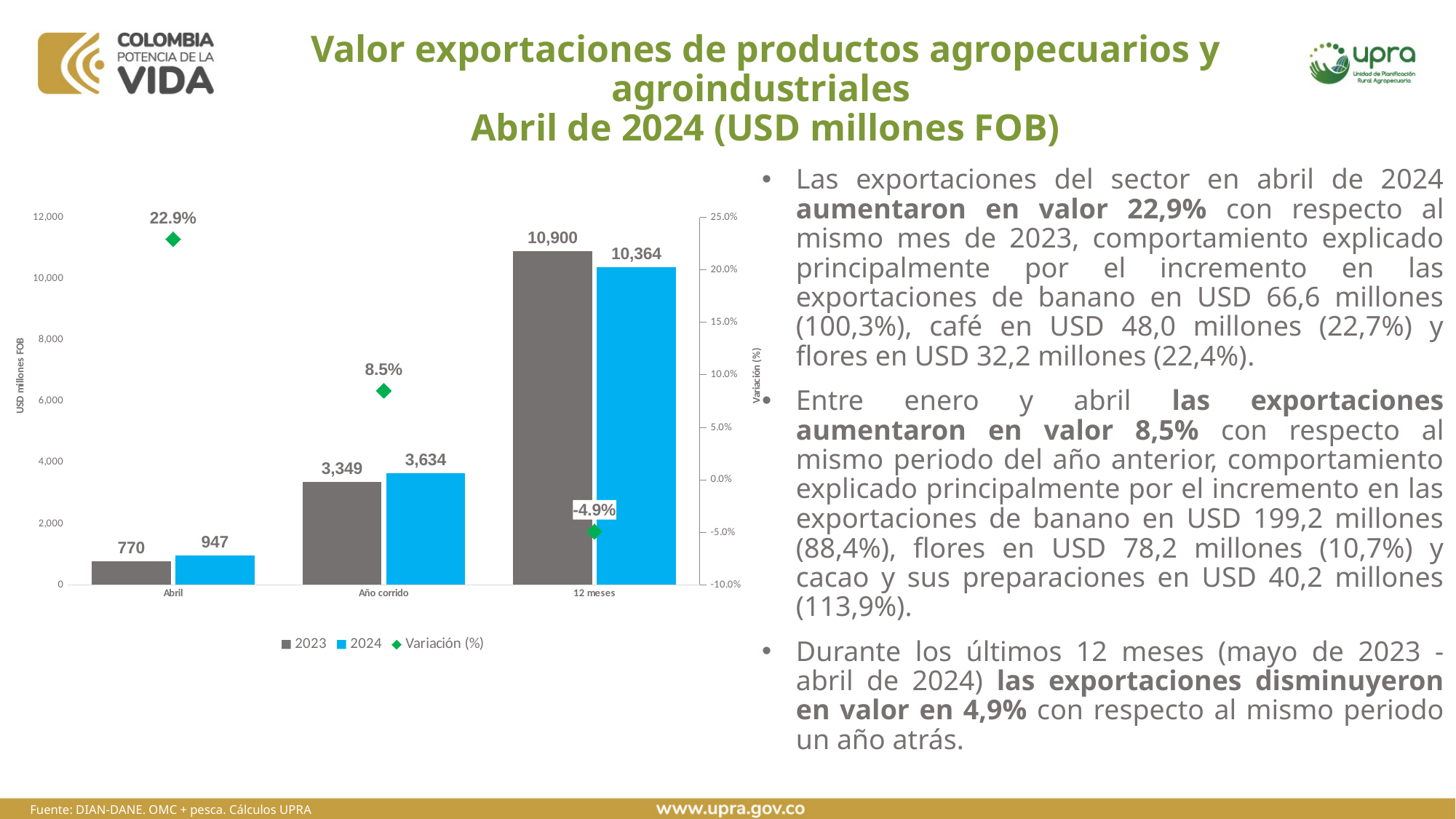
How many series does the legend list? 3 What is the label of the left vertical axis? USD millones FOB What is the difference between the 2023 and 2024 values for 12 meses? 536 What kind of chart is used for the 2023 and 2024 series? bar chart What is the Variación (%) for 12 meses? -4.9% Which category has the highest 2024 value? 12 meses What is the 2023 value for Abril? 770 Which category has the lowest 2023 value? Abril What is the 2024 value for Año corrido? 3,634 Which is larger for Abril, the 2023 value or the 2024 value? 2024 How many categories are shown on the x axis? 3 Does the Variación (%) rise or fall from Abril to 12 meses? fall